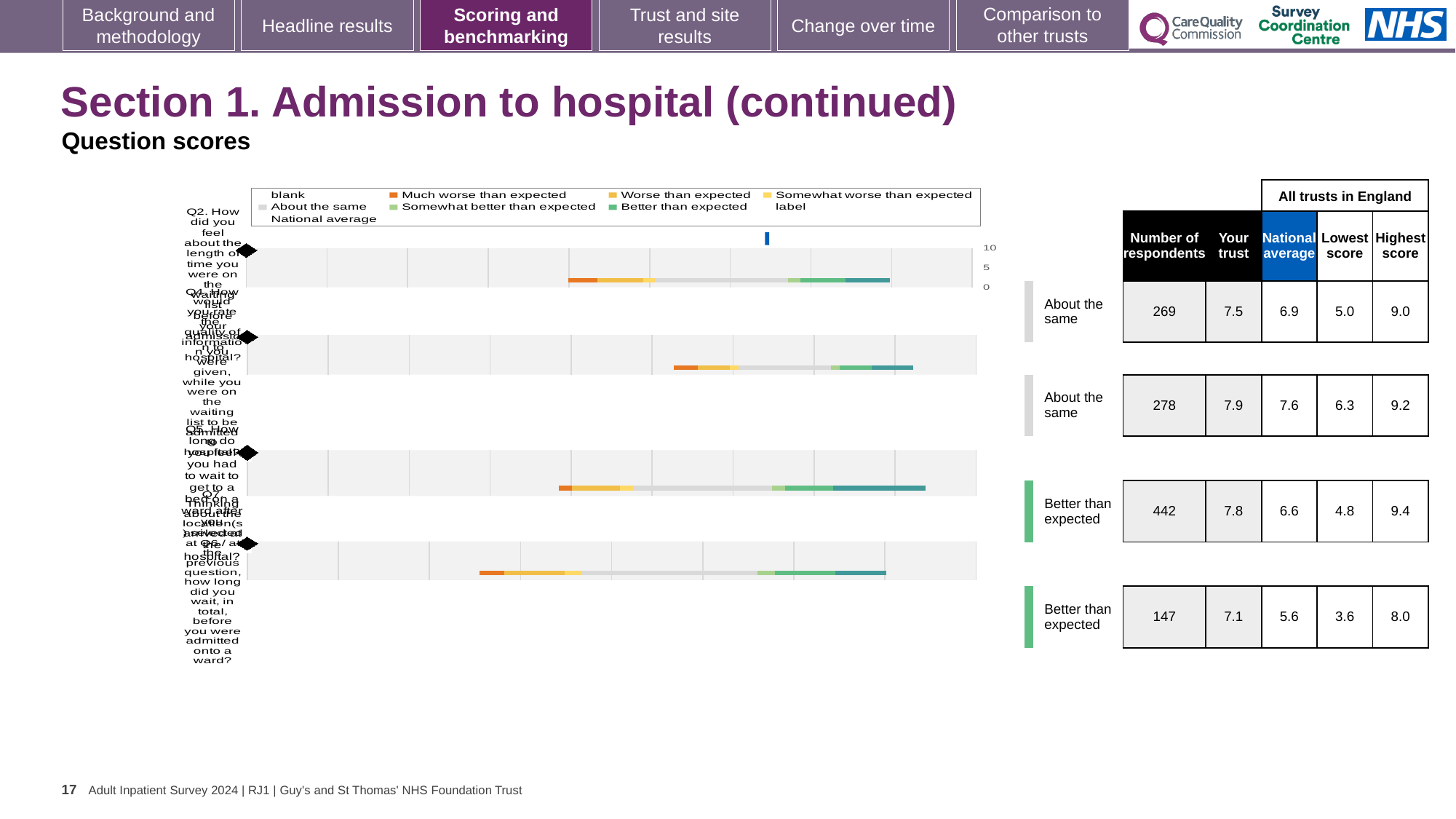
In the table to the right of the chart, what is the 'Your trust' score in the second row? 7.9 In the table to the right of the chart, what is the difference between 'Your trust' and 'National average' in the fourth row? 1.5 In the table to the right of the chart, what is the highest 'Highest score' value? 9.4 How many bars (survey questions) are plotted in the chart? 4 In the table to the right of the chart, what is the lowest 'Lowest score' value? 3.6 In the table to the right of the chart, which row has the highest number of respondents? the third row (442) How many entries does the chart legend list? 9 In the table to the right of the chart, what is the number of respondents in the first row? 269 In the table to the right of the chart, is the 'Your trust' score in the first row larger or smaller than the national average? larger What kind of chart is shown on the slide? bar chart What is the highest value shown on the chart's numeric axis? 10 What colour represents 'Much worse than expected' in the chart legend? orange